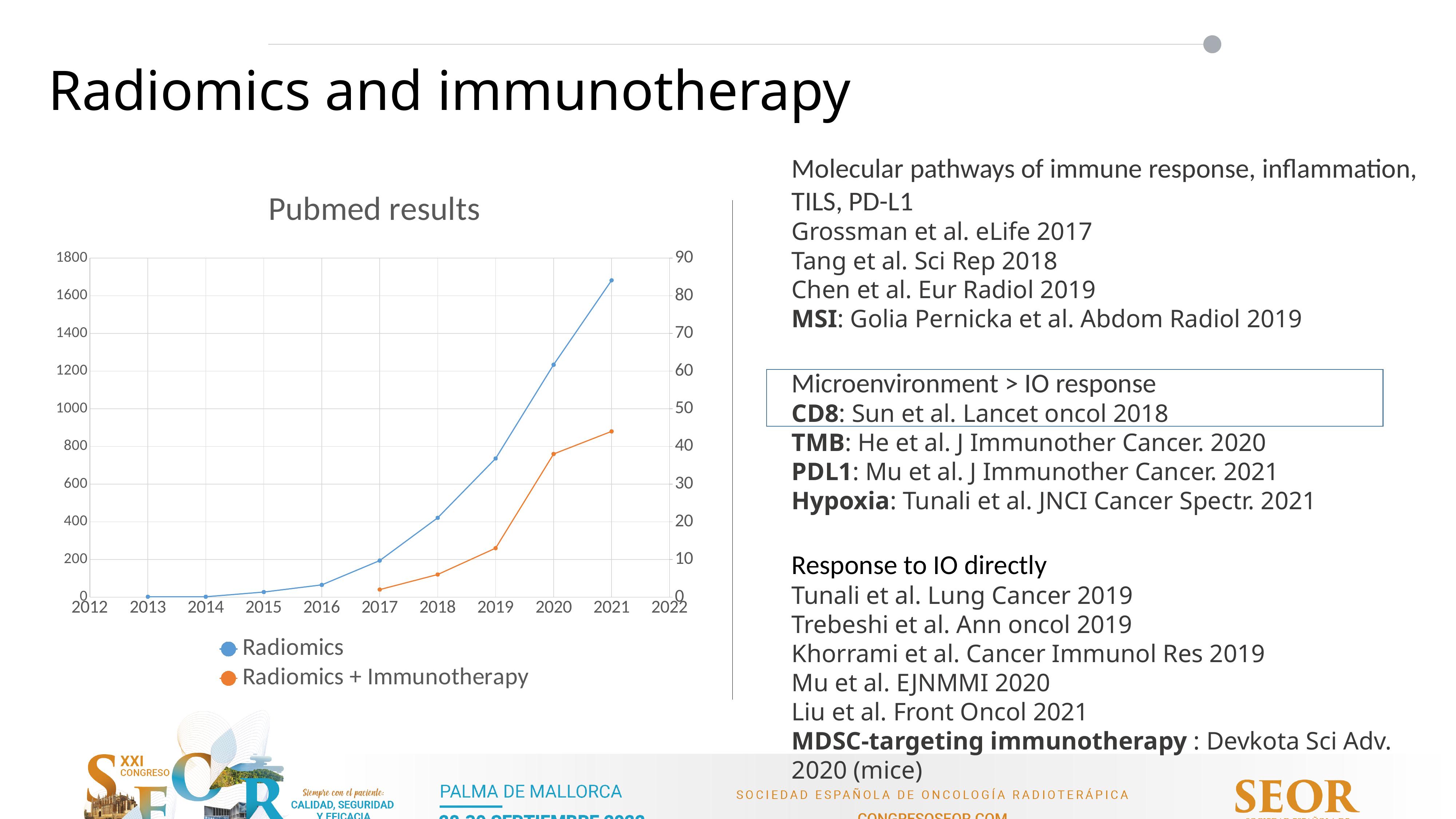
Is the Radiomics value for 2019 greater or less than 600 on the left axis? greater Is the Radiomics value for 2021 greater or less than 1600 on the left axis? greater In which year does the Radiomics series reach its highest value? 2021 Is the Radiomics value for 2018 greater or less than 600 on the left axis? less How many series does the chart legend list? 2 Which series is drawn in orange? Radiomics + Immunotherapy Do the Radiomics values rise or fall from 2013 to 2021? rise What kind of chart is shown on the slide? line chart What is the title of the chart? Pubmed results How many data points are plotted for the Radiomics + Immunotherapy series? 5 How many data points are plotted for the Radiomics series? 9